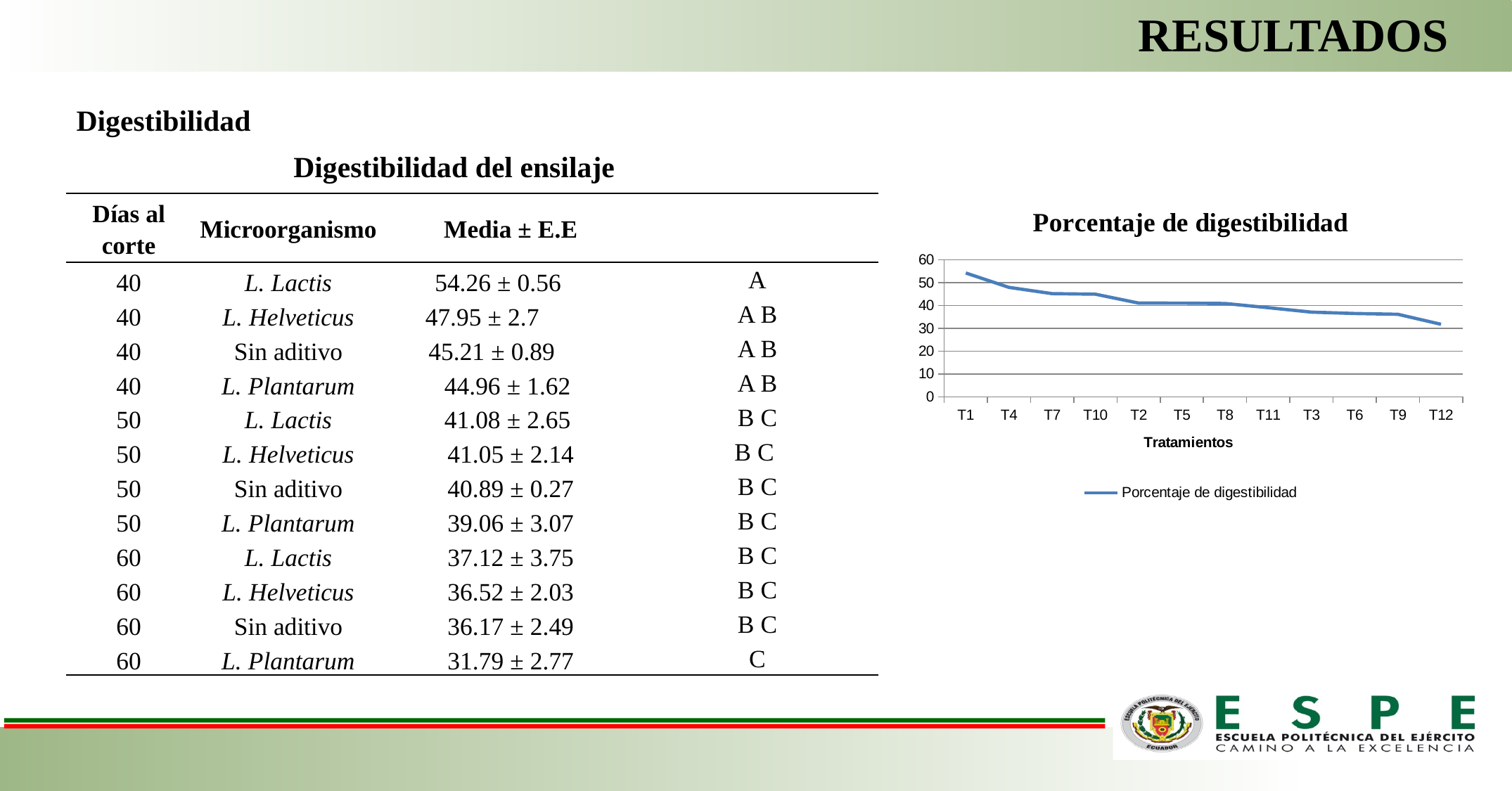
Which treatment has the highest value in the "Porcentaje de digestibilidad" chart? T1 In the "Porcentaje de digestibilidad" chart, is the value for T12 greater or less than 40? less How many treatments are plotted along the x axis of the "Porcentaje de digestibilidad" chart? 12 How many series does the legend of the "Porcentaje de digestibilidad" chart list? 1 In the "Porcentaje de digestibilidad" chart, is the value for T7 greater or less than 50? less What is the x-axis title of the "Porcentaje de digestibilidad" chart? Tratamientos In the "Porcentaje de digestibilidad" chart, is the value for T9 greater or less than 40? less What kind of chart is the "Porcentaje de digestibilidad" chart? line chart In the "Porcentaje de digestibilidad" chart, which has the larger value, T4 or T9? T4 Do the values in the "Porcentaje de digestibilidad" chart rise or fall from T1 to T12? fall Which treatment has the lowest value in the "Porcentaje de digestibilidad" chart? T12